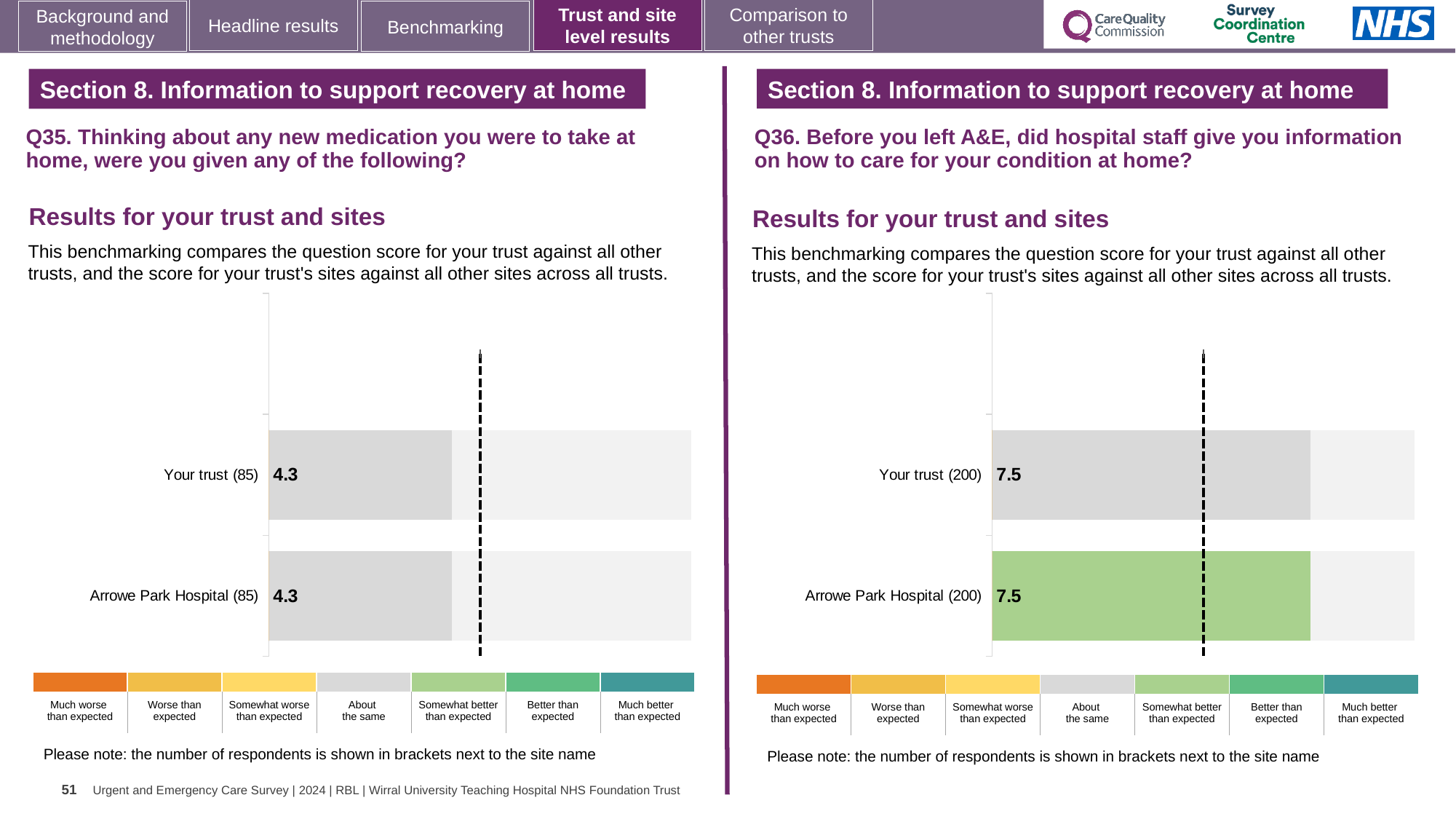
What kind of chart is used for the Q36 results on the right? Bar chart How many bars are plotted in the Q36 chart on the right? 2 In the Q36 chart on the right, is the score for Your trust larger than, smaller than, or equal to the score for Arrowe Park Hospital? equal In the Q35 chart on the left, what is the difference between the score for Your trust and the score for Arrowe Park Hospital? 0.0 In the Q36 chart on the right, which legend category does the green colour of the Arrowe Park Hospital bar correspond to? Somewhat better than expected In the Q35 chart on the left, what is the score for Your trust? 4.3 In the Q36 chart on the right, what is the score for Your trust? 7.5 In the Q36 chart on the right, what is the score for Arrowe Park Hospital? 7.5 In the Q35 chart on the left, what is the score for Arrowe Park Hospital? 4.3 How many respondents are shown in brackets for Your trust in the Q36 chart on the right? 200 How many bars are plotted in the Q35 chart on the left? 2 How many respondents are shown in brackets for Arrowe Park Hospital in the Q35 chart on the left? 85